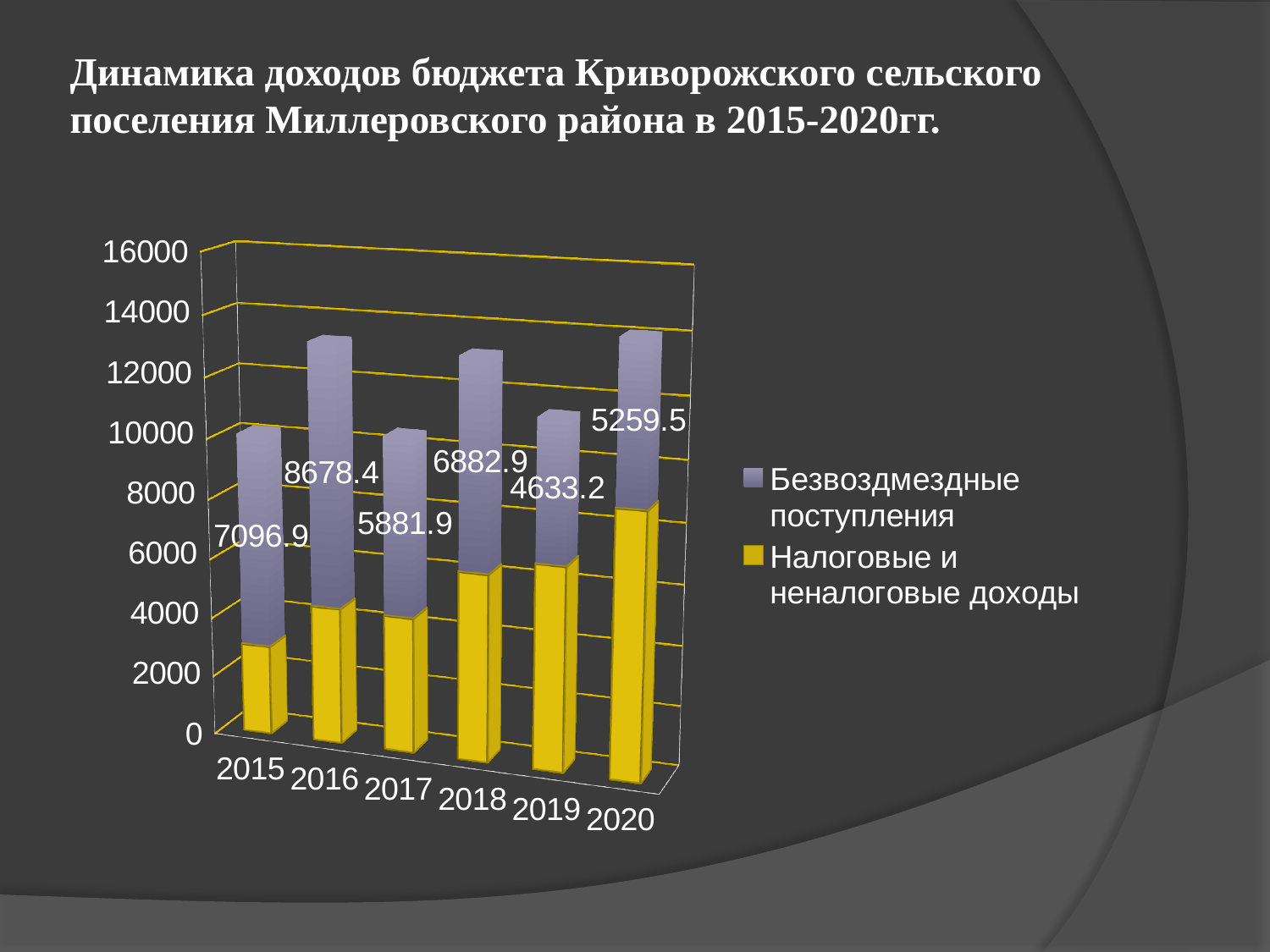
How many years are shown on the x axis of the chart? 6 What kind of chart is shown on the slide? Stacked bar chart What is the value of Безвоздмездные поступления for 2019? 4633.2 In which year is the value of Безвоздмездные поступления the lowest? 2019 In which year is the value of Безвоздмездные поступления the highest? 2016 What is the value of Безвоздмездные поступления for 2016? 8678.4 Is the value of Налоговые и неналоговые доходы for 2015 greater or less than 4000? less Is the value of Налоговые и неналоговые доходы for 2020 greater or less than 6000? greater What is the difference between the Безвоздмездные поступления values for 2016 and 2019? 4045.2 How many series does the legend list? 2 What is the value of Безвоздмездные поступления for 2020? 5259.5 Which year has a larger value of Безвоздмездные поступления, 2015 or 2018? 2015